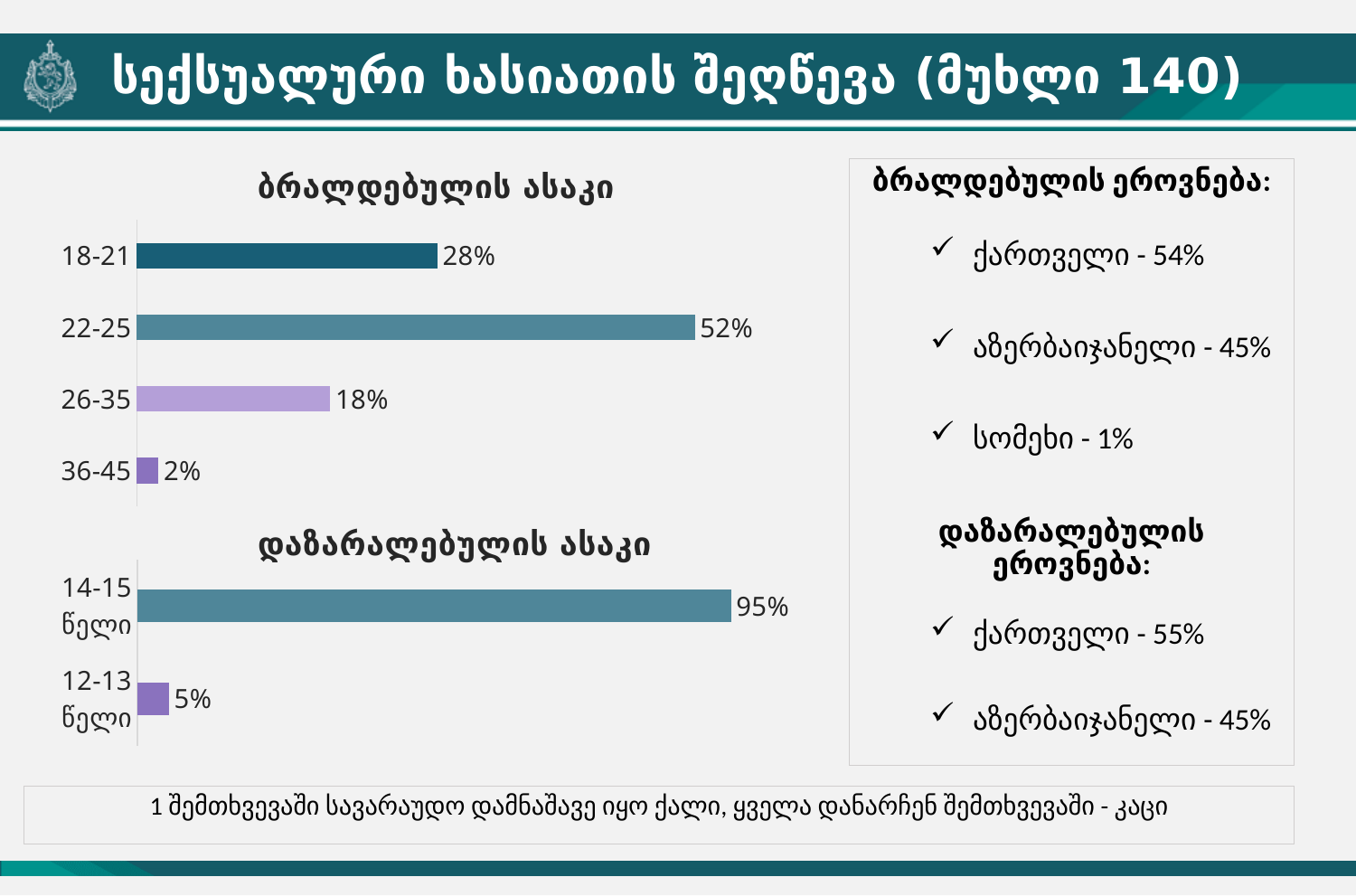
In the top chart (ბრალდებულის ასაკი), which age group has the lowest value? 36-45 What type of chart is the bottom chart (დაზარალებულის ასაკი)? Bar chart In the top chart (ბრალდებულის ასაკი), what is the value for the 36-45 age group? 2% In the top chart (ბრალდებულის ასაკი), what is the difference between the values for 22-25 and 18-21? 24% In the bottom chart (დაზარალებულის ასაკი), what is the value for 14-15 წელი? 95% In the bottom chart (დაზარალებულის ასაკი), what is the value for 12-13 წელი? 5% In the top chart (ბრალდებულის ასაკი), what is the value for the 22-25 age group? 52% What is the title of the top chart on the slide? ბრალდებულის ასაკი In the bottom chart (დაზარალებულის ასაკი), what is the difference between the values for 14-15 წელი and 12-13 წელი? 90% In the top chart (ბრალდებულის ასაკი), which age group has the highest value? 22-25 How many age categories are shown in the top chart (ბრალდებულის ასაკი)? 4 In the top chart (ბრალდებულის ასაკი), which is larger: the value for 18-21 or for 26-35? 18-21